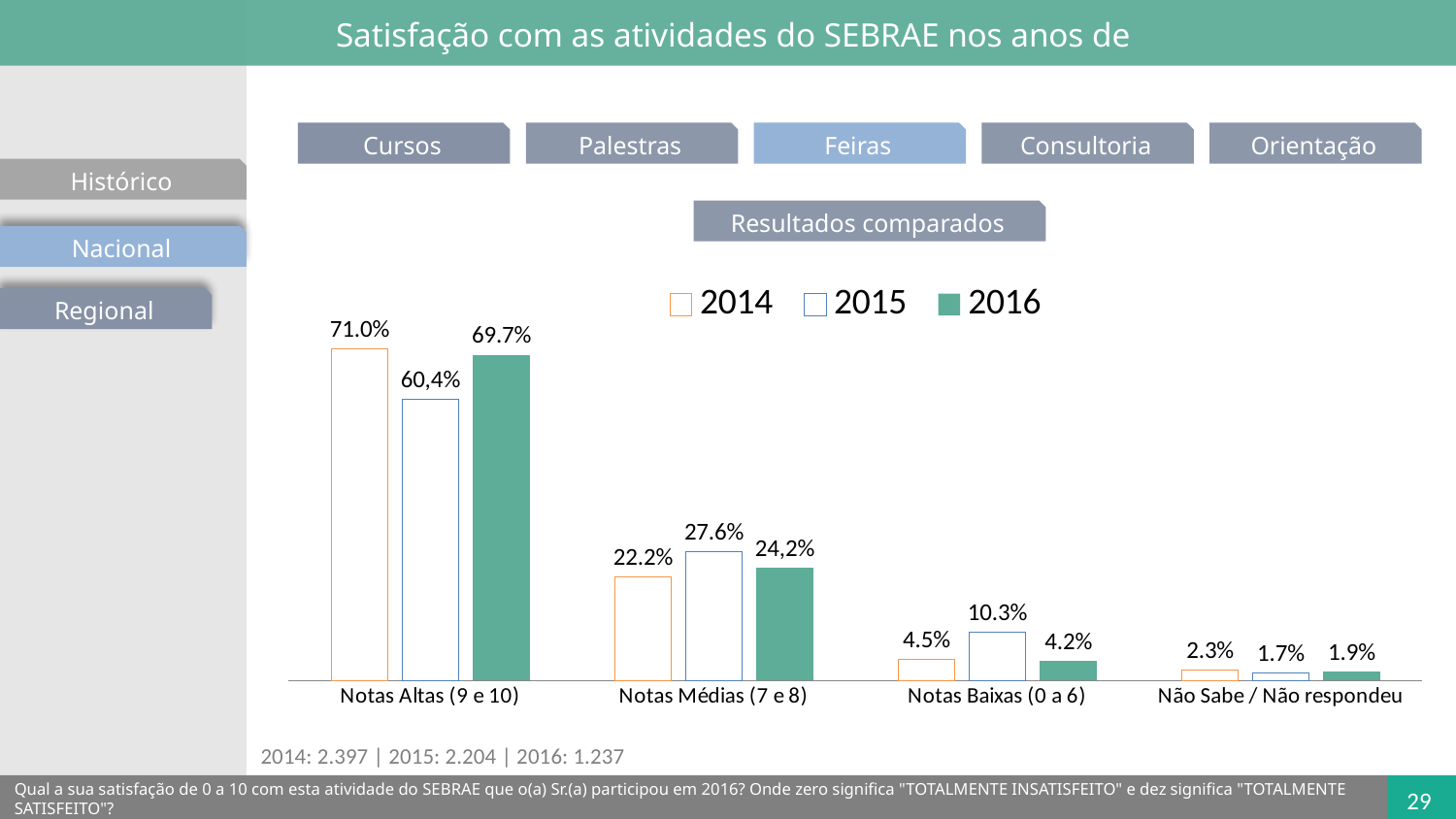
Which category has the highest value for 2016? Notas Altas (9 e 10) What is the value for 2015 in the Notas Baixas (0 a 6) category? 10.3% What is the value for 2016 in the Notas Médias (7 e 8) category? 24,2% In the Notas Baixas (0 a 6) category, which year has the larger value, 2014 or 2016? 2014 What is the value for 2016 in the Não Sabe / Não respondeu category? 1.9% How many series does the chart legend list? 3 Which category has the lowest value for 2014? Não Sabe / Não respondeu What kind of chart is shown on the slide? Bar chart What is the value for 2014 in the Notas Altas (9 e 10) category? 71.0% What is the difference between the 2015 and 2014 values in the Notas Médias (7 e 8) category? 5.4 percentage points What is the value for 2015 in the Notas Altas (9 e 10) category? 60,4% How many categories are shown on the x axis of the chart? 4